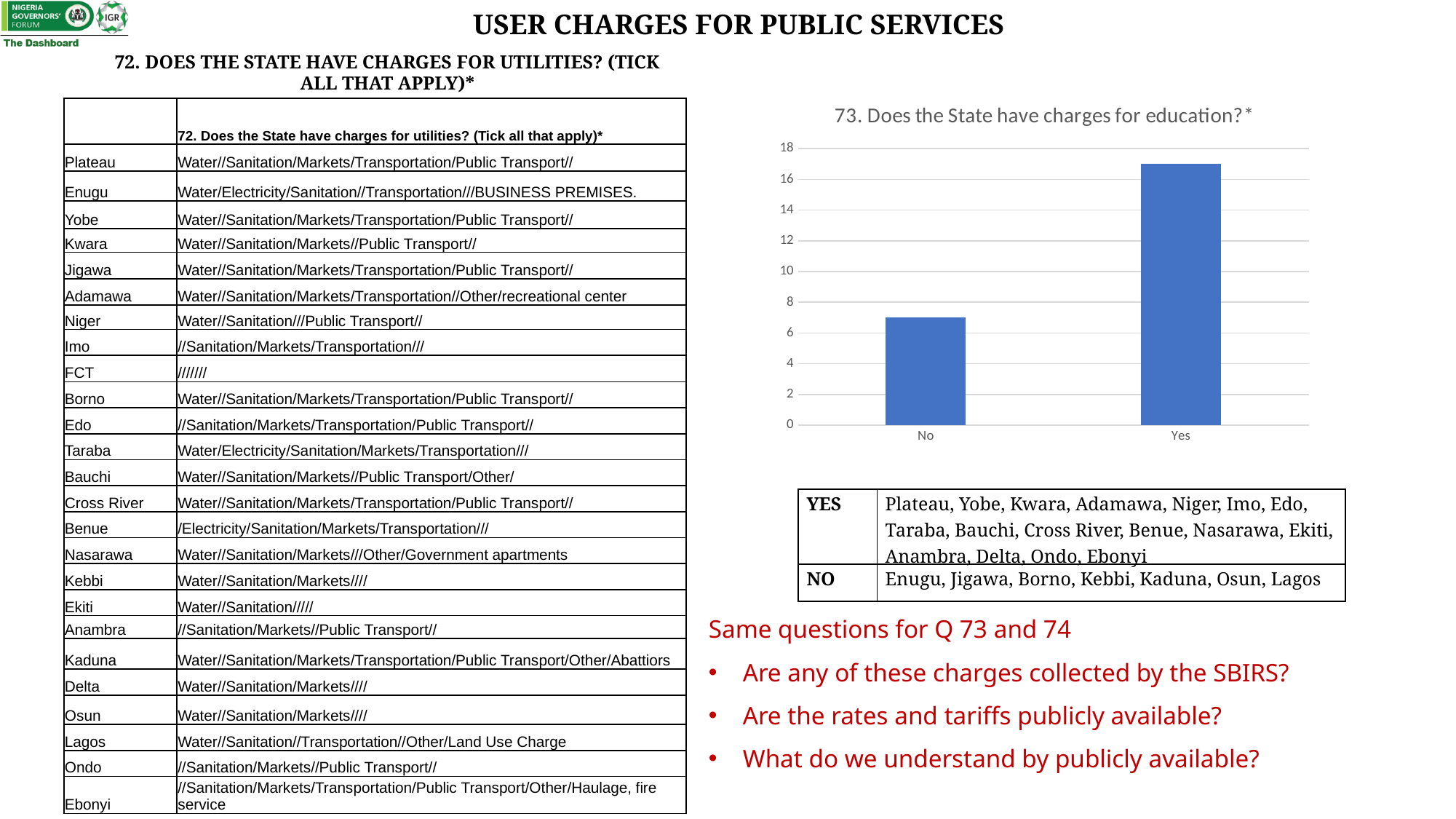
What is the title of the chart on the slide? 73. Does the State have charges for education?* Is the value for Yes greater or less than 16? greater Which category has the highest bar in the chart? Yes Which category has the lowest bar in the chart? No How many categories are shown on the x axis of the chart? 2 What kind of chart is shown on the slide? bar chart Is the value for No greater or less than 8? less What is the highest value shown on the y axis of the chart? 18 Is the value for No greater or less than 6? greater Which is larger in the chart, the value for Yes or the value for No? Yes